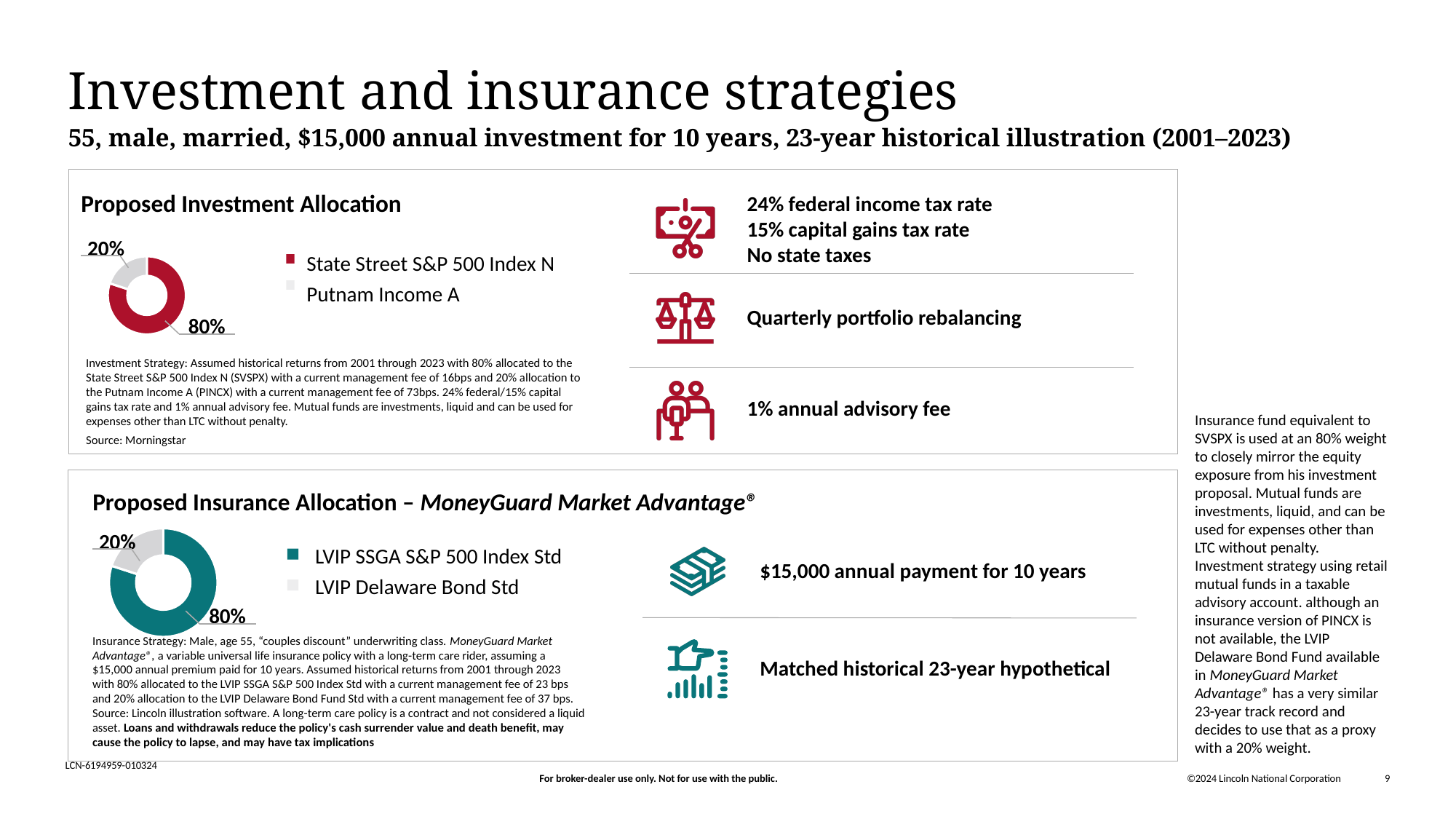
What type of chart is used for the Proposed Investment Allocation? Donut (pie) chart What colour is the LVIP SSGA S&P 500 Index Std slice in the Proposed Insurance Allocation chart? Teal In the Proposed Insurance Allocation chart, what share is allocated to LVIP SSGA S&P 500 Index Std? 80% How many entries does the legend of the Proposed Investment Allocation chart list? 2 In the Proposed Investment Allocation chart, which fund has the largest share? State Street S&P 500 Index N In the Proposed Insurance Allocation chart, what share is allocated to LVIP Delaware Bond Std? 20% In the Proposed Investment Allocation chart, which fund has the smallest share? Putnam Income A In the Proposed Investment Allocation chart, what share is allocated to State Street S&P 500 Index N? 80% In the Proposed Investment Allocation chart, what share is allocated to Putnam Income A? 20% In the Proposed Investment Allocation chart, what is the difference between the State Street S&P 500 Index N share and the Putnam Income A share? 60% In the Proposed Insurance Allocation chart, which fund has the larger share, LVIP SSGA S&P 500 Index Std or LVIP Delaware Bond Std? LVIP SSGA S&P 500 Index Std How many slices does the Proposed Insurance Allocation chart have? 2